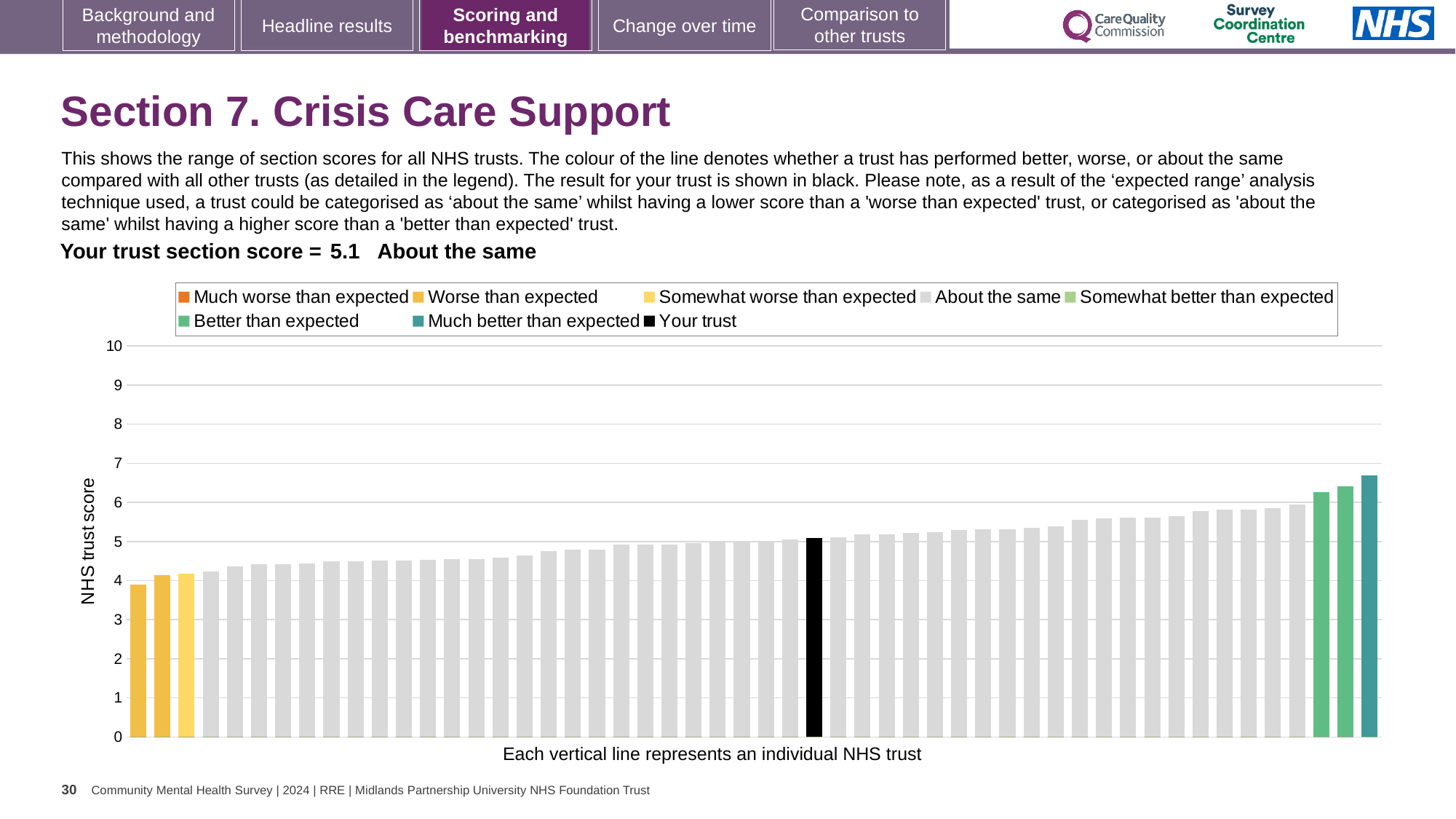
Do the bar values rise or fall from left to right along the x axis? rise What kind of chart is shown on the slide? bar chart Is the value for your trust greater or less than 6? less Is the value of the tallest bar greater or less than 6? greater Is the value of the shortest bar greater or less than 5? less Which category is your trust placed in for this section? About the same How many bars are coloured as 'Better than expected'? 2 Which legend category does the tallest bar belong to? Much better than expected How many entries does the chart legend list? 8 What is the label on the y axis of the chart? NHS trust score What is the section score for your trust shown on the slide? 5.1 Which legend category does the shortest bar belong to? Worse than expected